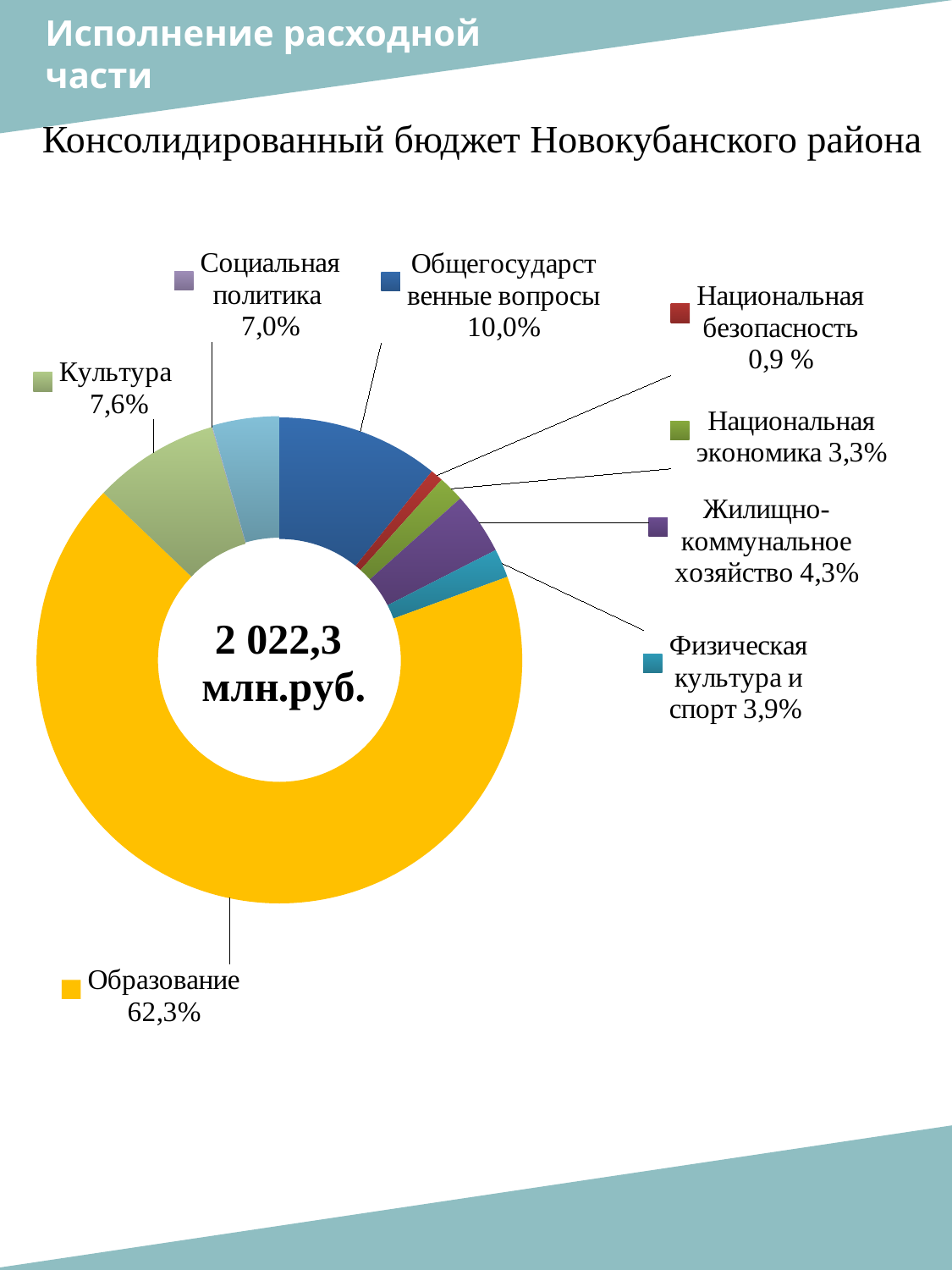
What is the title written above the chart? Консолидированный бюджет Новокубанского района What is the value shown for Жилищно-коммунальное хозяйство? 4,3% What kind of chart is shown on the slide? Doughnut (pie) chart What is the value shown for Национальная безопасность? 0,9 % How many categories are shown in the chart? 8 Which category has the smallest share of the chart? Национальная безопасность Which is larger, the share of Физическая культура и спорт or the share of Национальная экономика? Физическая культура и спорт Which category has the largest share of the chart? Образование What is the value shown for Общегосударственные вопросы? 10,0% What share of the chart does Образование account for? 62,3% What total amount is printed in the centre of the chart? 2 022,3 млн.руб. What is the difference between the shares of Культура and Социальная политика? 0,6%